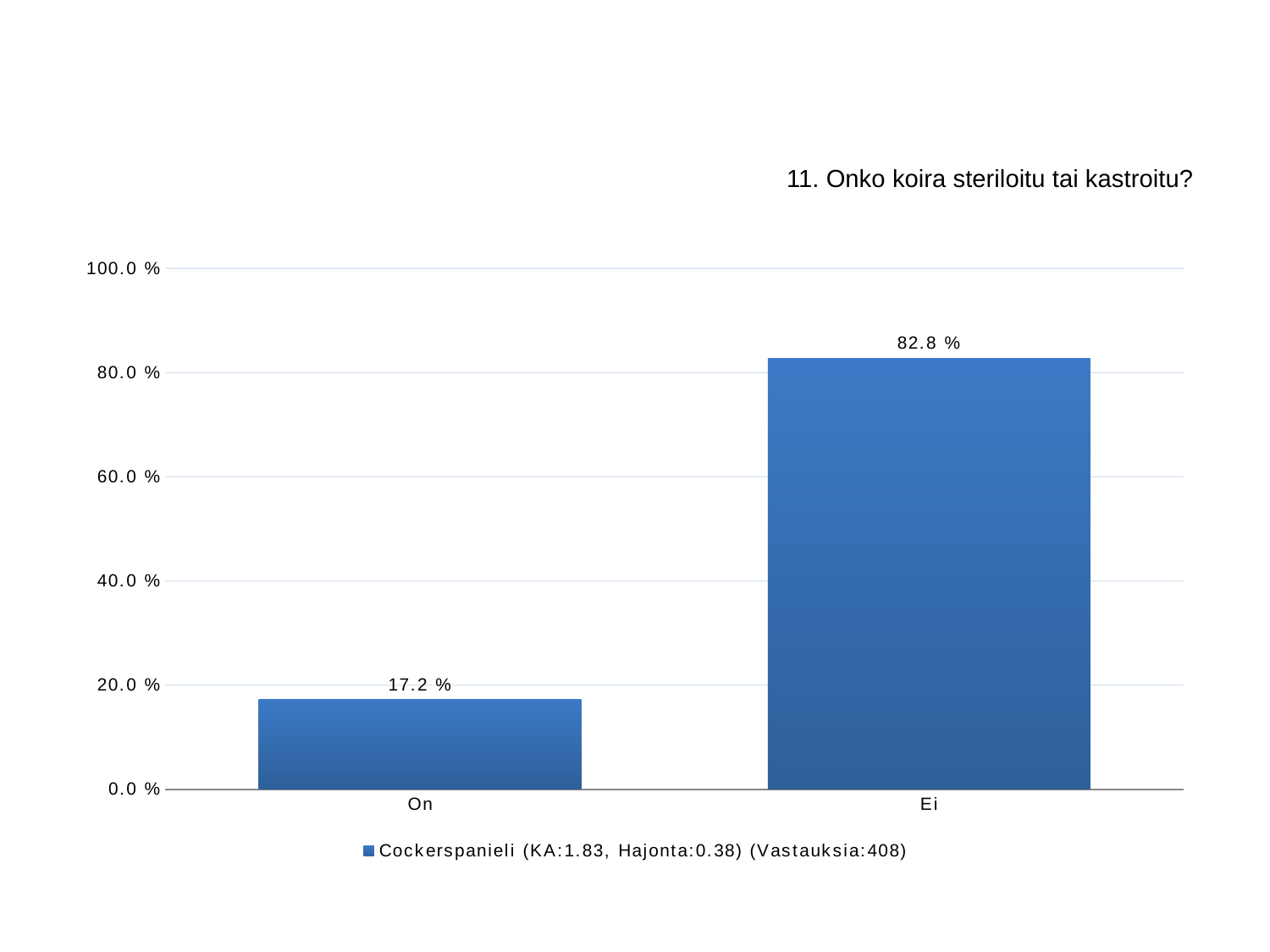
Which category has the highest value? Ei How many series does the legend list? 1 Which category has the lowest value? On How many categories are shown on the x axis? 2 What kind of chart is shown on the slide? bar chart What is the value for "On"? 17.2 % What is the value for "Ei"? 82.8 % Which is larger, the value for "On" or the value for "Ei"? Ei Is the value for "Ei" greater or less than 80.0 %? greater What is the difference between the values for "Ei" and "On"? 65.6 % Is the value for "On" greater or less than 20.0 %? less What is the title of the chart? 11. Onko koira steriloitu tai kastroitu?